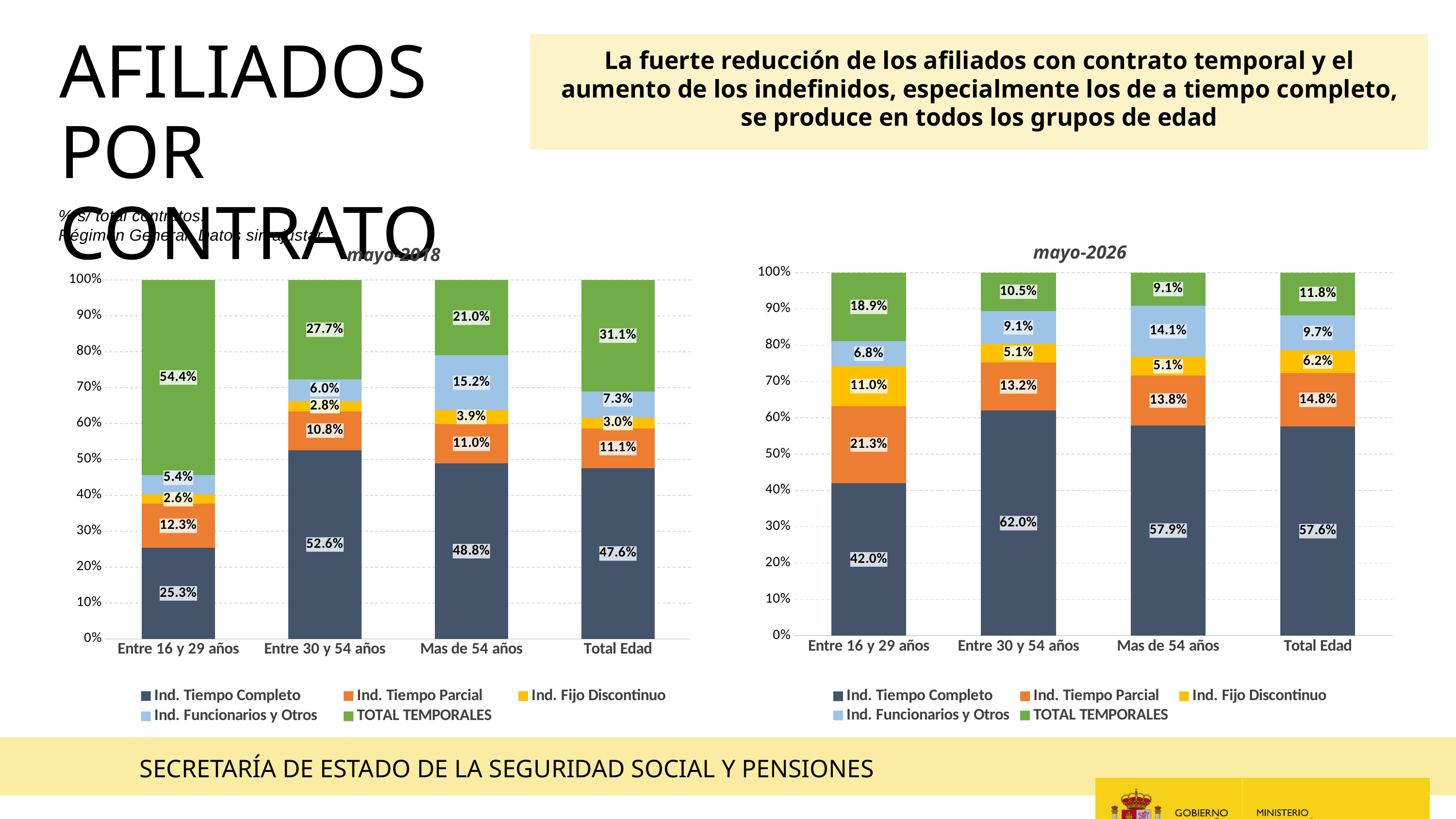
In the mayo-2026 chart, which is larger for Entre 16 y 29 años: Ind. Tiempo Parcial or Ind. Fijo Discontinuo? Ind. Tiempo Parcial In the mayo-2026 chart, which age group has the lowest TOTAL TEMPORALES value? Mas de 54 años In the mayo-2026 chart, what is the value of Ind. Tiempo Parcial for Total Edad? 14.8% How many age categories are shown on the x axis of the mayo-2018 chart? 4 In the mayo-2018 chart, which series is shown in green? TOTAL TEMPORALES How many series does the legend of the mayo-2026 chart list? 5 In the mayo-2018 chart, what is the value of TOTAL TEMPORALES for Entre 16 y 29 años? 54.4% In the mayo-2018 chart, what is the value of Ind. Funcionarios y Otros for Mas de 54 años? 15.2% In the mayo-2018 chart, which age group has the highest Ind. Tiempo Completo value? Entre 30 y 54 años What is the difference between the TOTAL TEMPORALES value for Entre 16 y 29 años in the mayo-2018 chart and in the mayo-2026 chart? 35.5% What kind of chart is the mayo-2018 chart? Stacked bar chart In the mayo-2026 chart, what is the value of Ind. Tiempo Completo for Entre 30 y 54 años? 62.0%